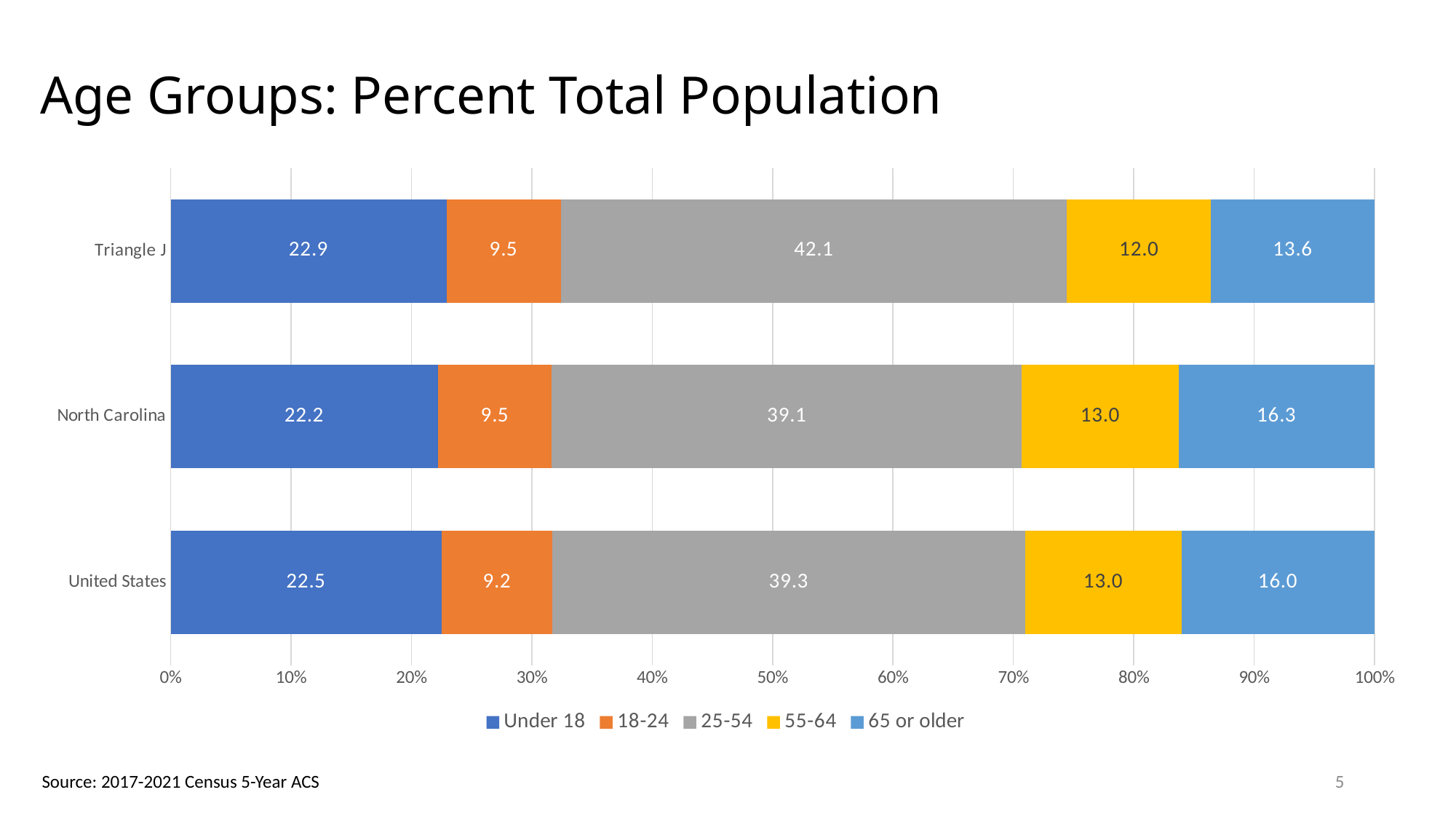
What is the title of the chart? Age Groups: Percent Total Population Which region has the lowest value for the 65 or older age group? Triangle J What is the value for the 25-54 age group for Triangle J? 42.1 What is the value for the 18-24 age group for the United States? 9.2 Which is larger, the Under 18 value for Triangle J or for the United States? Triangle J What kind of chart is shown on the slide? Stacked bar chart What is the value for the 55-64 age group for Triangle J? 12.0 Which region has the highest value for the 25-54 age group? Triangle J How many age groups does the legend list? 5 What is the value for the 65 or older age group for North Carolina? 16.3 How many regions are shown on the chart? 3 What is the difference between the 65 or older values for North Carolina and Triangle J? 2.7